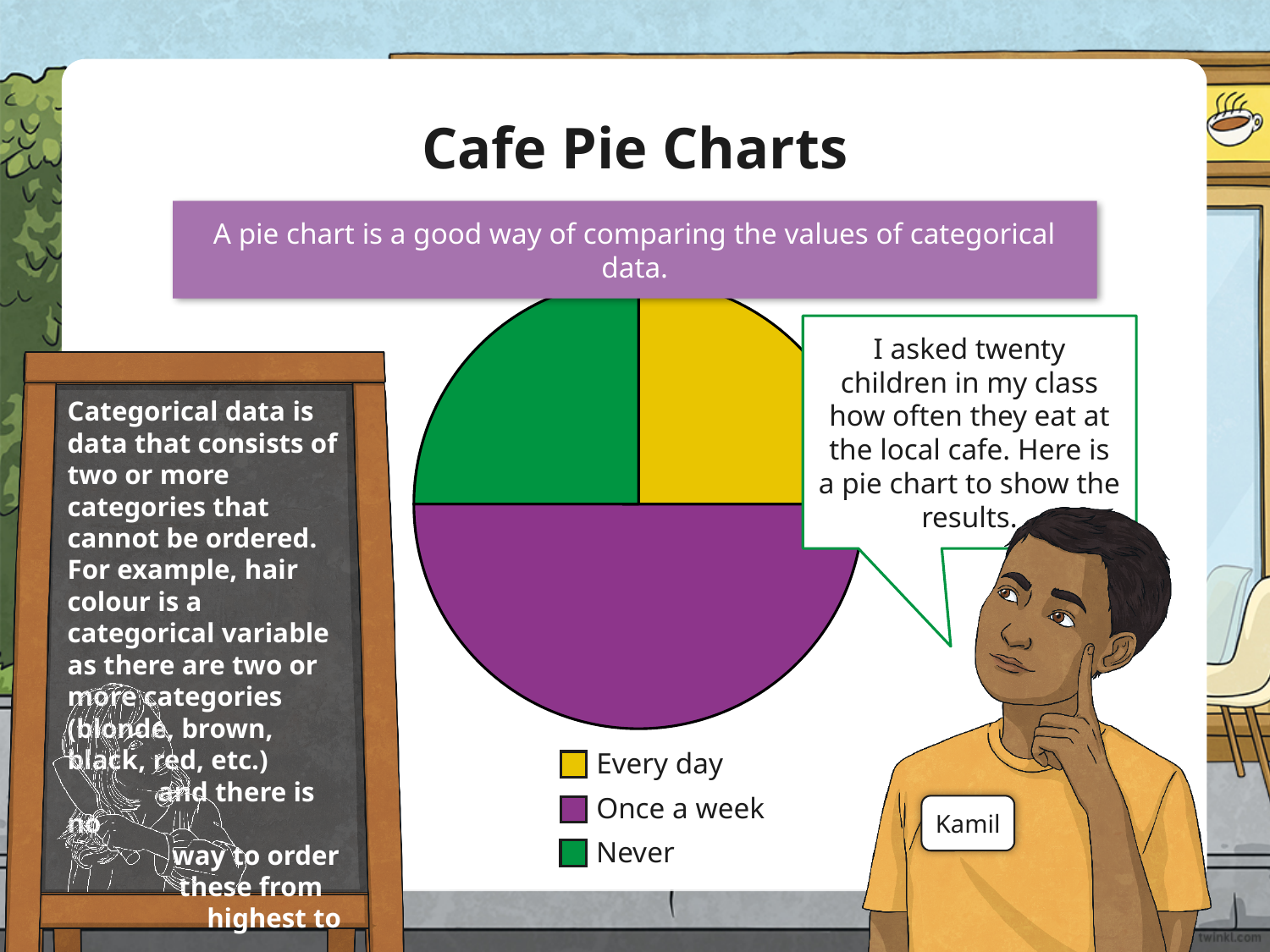
Which category has the largest slice of the pie chart? Once a week What colour is the Every day slice in the pie chart? yellow How many entries does the legend of the pie chart list? 3 What kind of chart is shown on the slide? pie chart Which slice is larger, Once a week or Never? Once a week How many categories does the pie chart show? 3 Which slice is larger, Once a week or Every day? Once a week What colour is the Never slice in the pie chart? green